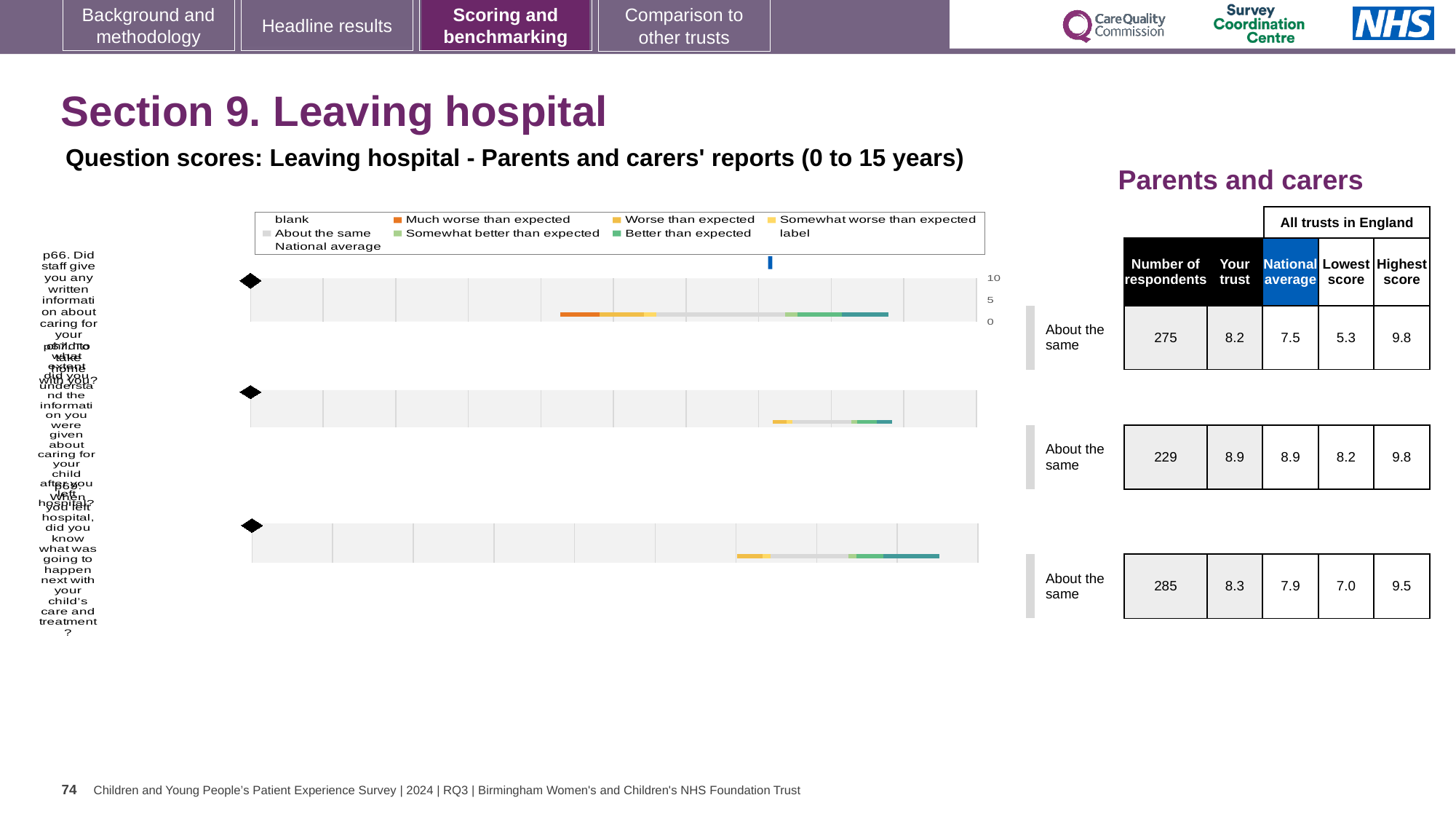
For the first (top) chart, what is the 'Your trust' score? 8.2 For the first (top) chart, what is the difference between the 'Your trust' score and the national average? 0.7 What benchmark rating is shown next to each of the three charts? About the same How many question charts are shown on the slide? 3 What kind of chart is used for each question on the slide? bar chart Which of the three charts has the lowest number of respondents? the second (middle) chart For the third (bottom) chart, what is the highest score among all trusts in England? 9.5 For the first (top) chart, what is the lowest score among all trusts in England? 5.3 For the first (top) chart, how many respondents are listed in the table? 275 For the second (middle) chart, what is the national average score? 8.9 For the third (bottom) chart, which is larger: the 'Your trust' score or the national average? Your trust Which of the three charts has the highest 'Your trust' score? the second (middle) chart